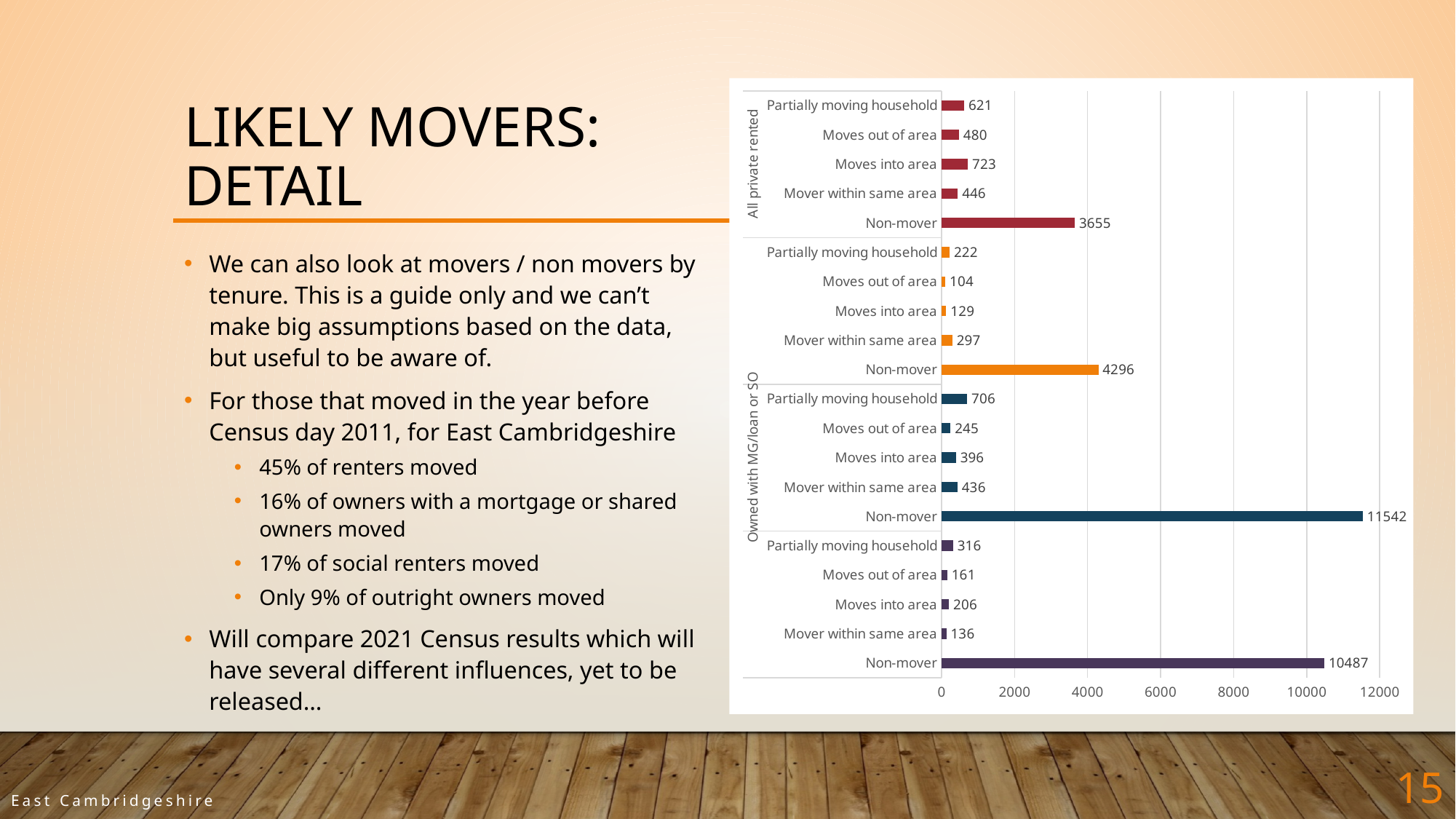
What is the highest value shown on the horizontal axis? 12000 What is the value for Partially moving household in the Owned with MG/loan or SO group? 706 Which is larger in the Owned with MG/loan or SO group: Mover within same area or Moves into area? Mover within same area Which category has the lowest value in the All private rented group? Mover within same area How many bars are plotted in the chart? 20 What type of chart is shown on the slide? bar chart What is the value for Non-mover in the Owned with MG/loan or SO group? 11542 What is the value for Non-mover in the bottom (purple) group of bars? 10487 What is the difference between Moves into area and Moves out of area in the All private rented group? 243 What is the value for Moves into area in the All private rented group? 723 What is the value for Non-mover in the All private rented group? 3655 Which bar has the highest value in the whole chart? Non-mover (Owned with MG/loan or SO)